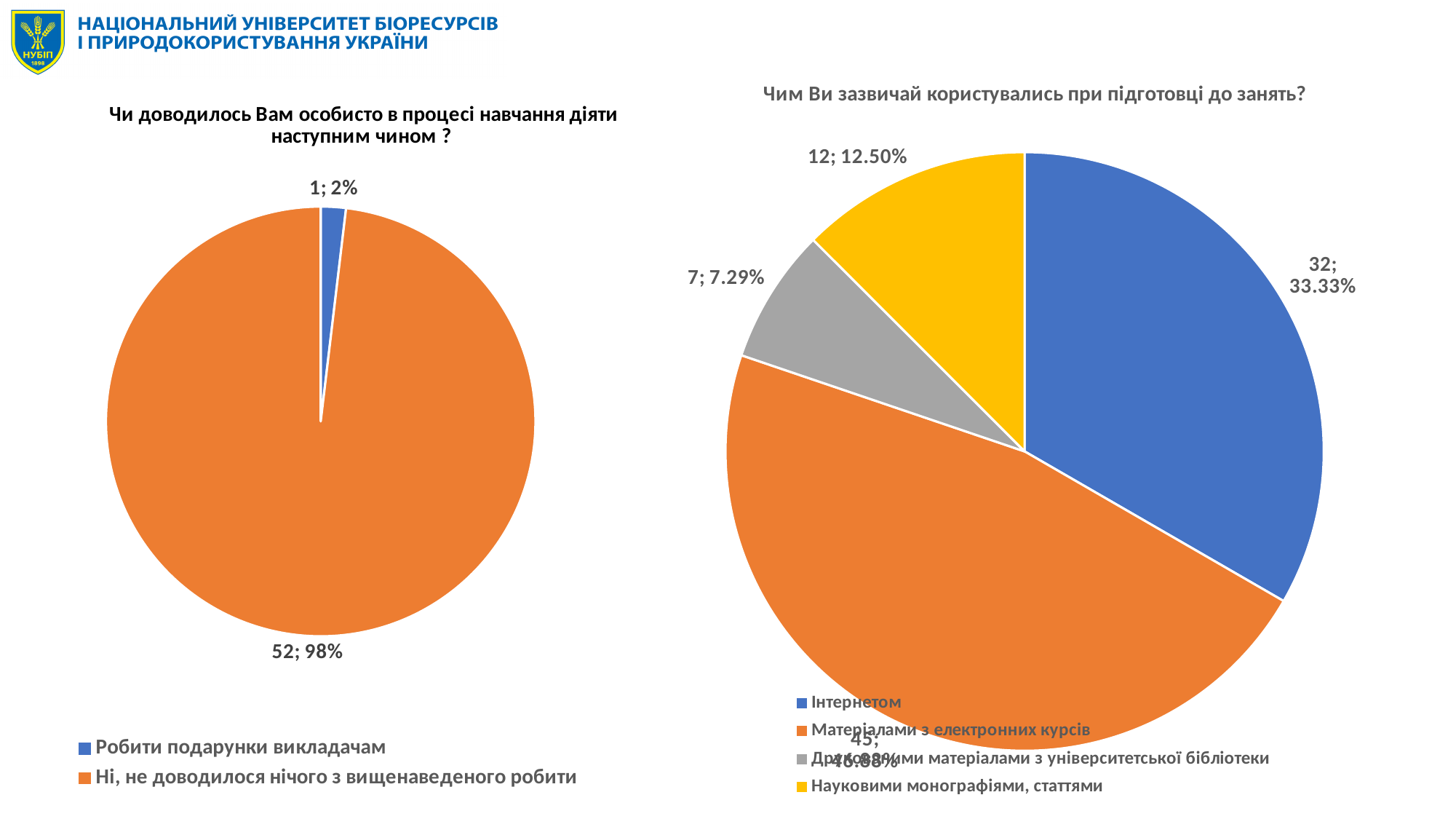
How many categories does the legend of the right pie chart list? 4 In the left pie chart, how many categories are shown? 2 What type of chart is the left chart titled "Чи доводилось Вам особисто в процесі навчання діяти наступним чином ?"? pie chart In the right pie chart, which category has the smallest slice? Друкованими матеріалами з університетської бібліотеки In the right pie chart, how many respondents chose "Інтернетом"? 32 In the right pie chart, what percentage share does "Науковими монографіями, статтями" have? 12.50% In the right pie chart, what is the difference in respondent count between "Інтернетом" and "Науковими монографіями, статтями"? 20 In the left pie chart, what percentage share does "Ні, не доводилося нічого з вищенаведеного робити" have? 98% In the left pie chart, how many respondents chose "Робити подарунки викладачам"? 1 In the left pie chart, which category has the largest slice? Ні, не доводилося нічого з вищенаведеного робити In the right pie chart, how many respondents chose "Друкованими матеріалами з університетської бібліотеки"? 7 In the right pie chart, which category has the largest slice? Матеріалами з електронних курсів